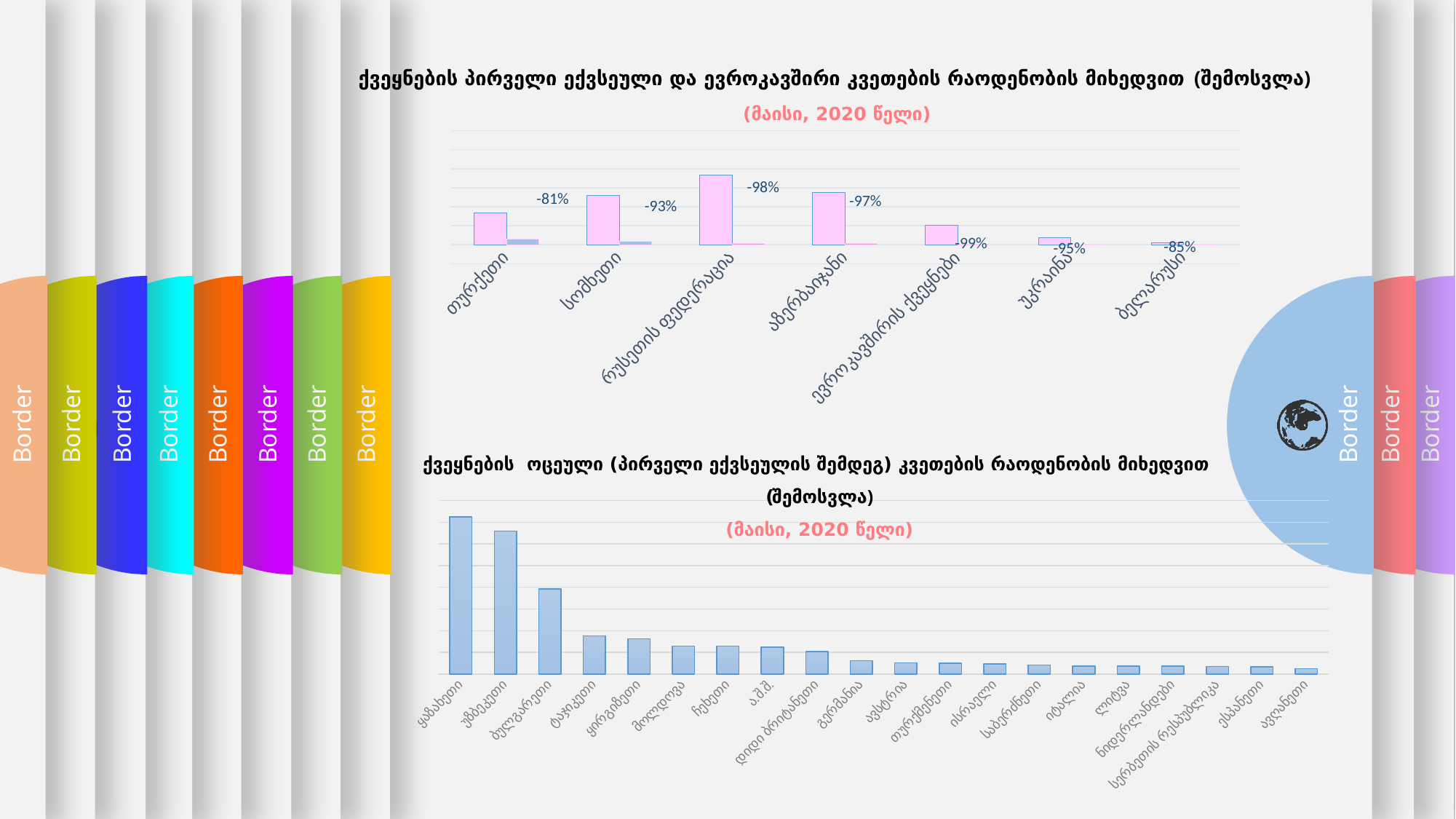
In the bottom chart, do the bar values rise or fall from left to right? fall In the top chart, what percentage change is shown for რუსეთის ფედერაცია? -98% In the top chart, what percentage change is shown for ევროკავშირის ქვეყნები? -99% What kind of chart is the bottom chart? bar chart In the top chart, which category has the tallest pink bar? რუსეთის ფედერაცია In the top chart, what percentage change is shown for თურქეთი? -81% In the bottom chart, how many countries are shown on the x axis? 20 In the top chart, what percentage change is shown for ბელარუსი? -85% In the bottom chart, which country has the highest bar? ყაზახეთი In the top chart, how many categories are shown on the x axis? 7 In the top chart, which category shows the largest percentage decline? ევროკავშირის ქვეყნები In the top chart, which category shows the smallest percentage decline? თურქეთი